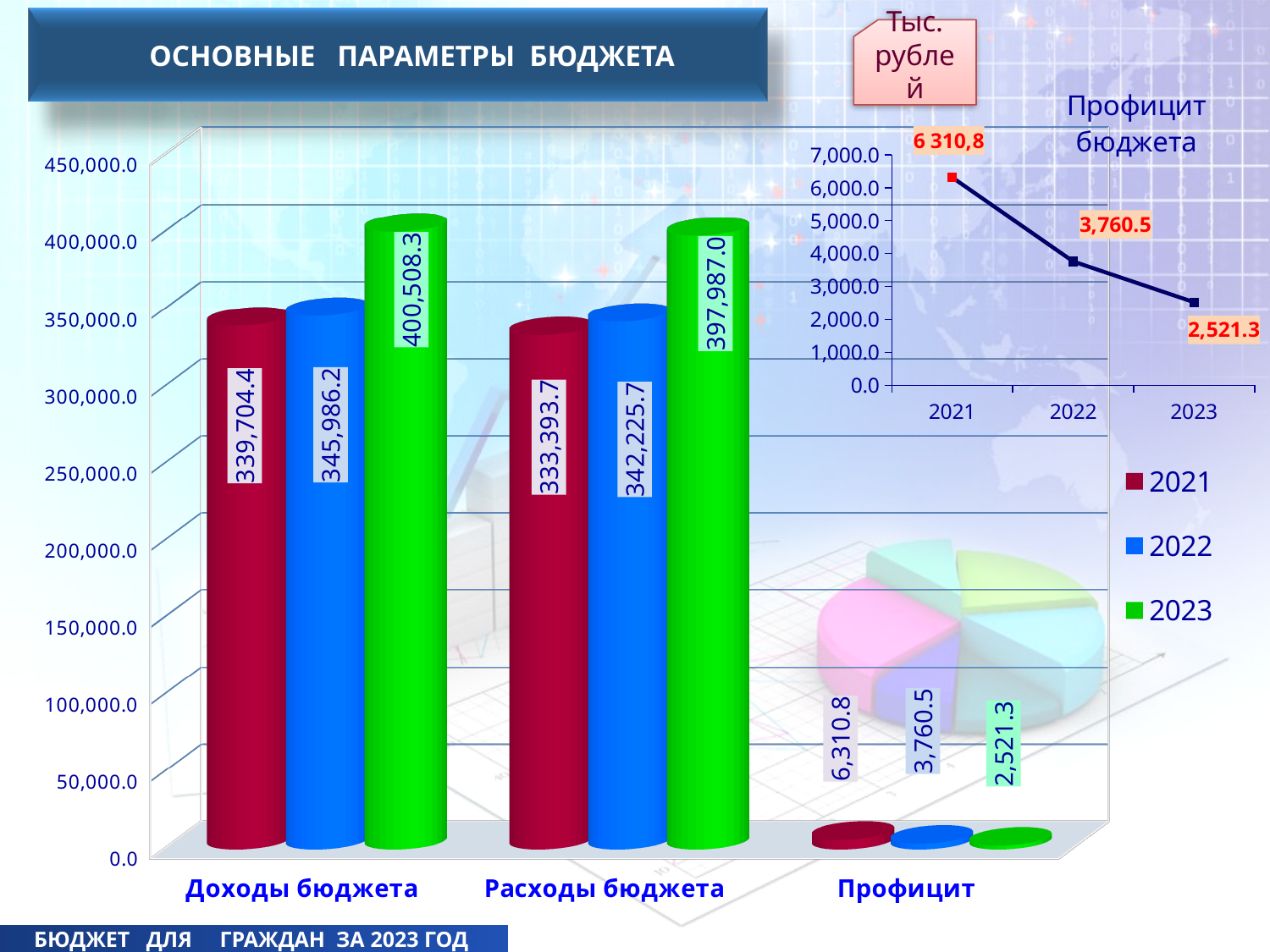
In the main bar chart, what is the value for Профицит in 2022? 3,760.5 In the main bar chart, which year has the lowest value for Профицит? 2023 In the main bar chart, what is the difference between Доходы бюджета in 2023 and in 2021? 60,803.9 In the main bar chart, which year has the highest value for Расходы бюджета? 2023 In the main bar chart, what is the value for Расходы бюджета in 2021? 333,393.7 In the chart titled Профицит бюджета, what is the value for 2022? 3,760.5 In the main bar chart, what is the value for Доходы бюджета in 2023? 400,508.3 How many categories are shown on the x axis of the main bar chart? 3 How many series does the legend of the main bar chart list? 3 In the chart titled Профицит бюджета, do the values rise or fall from 2021 to 2023? fall In the main bar chart, which is larger: Доходы бюджета in 2022 or Расходы бюджета in 2022? Доходы бюджета in 2022 What kind of chart is the chart titled Профицит бюджета? line chart